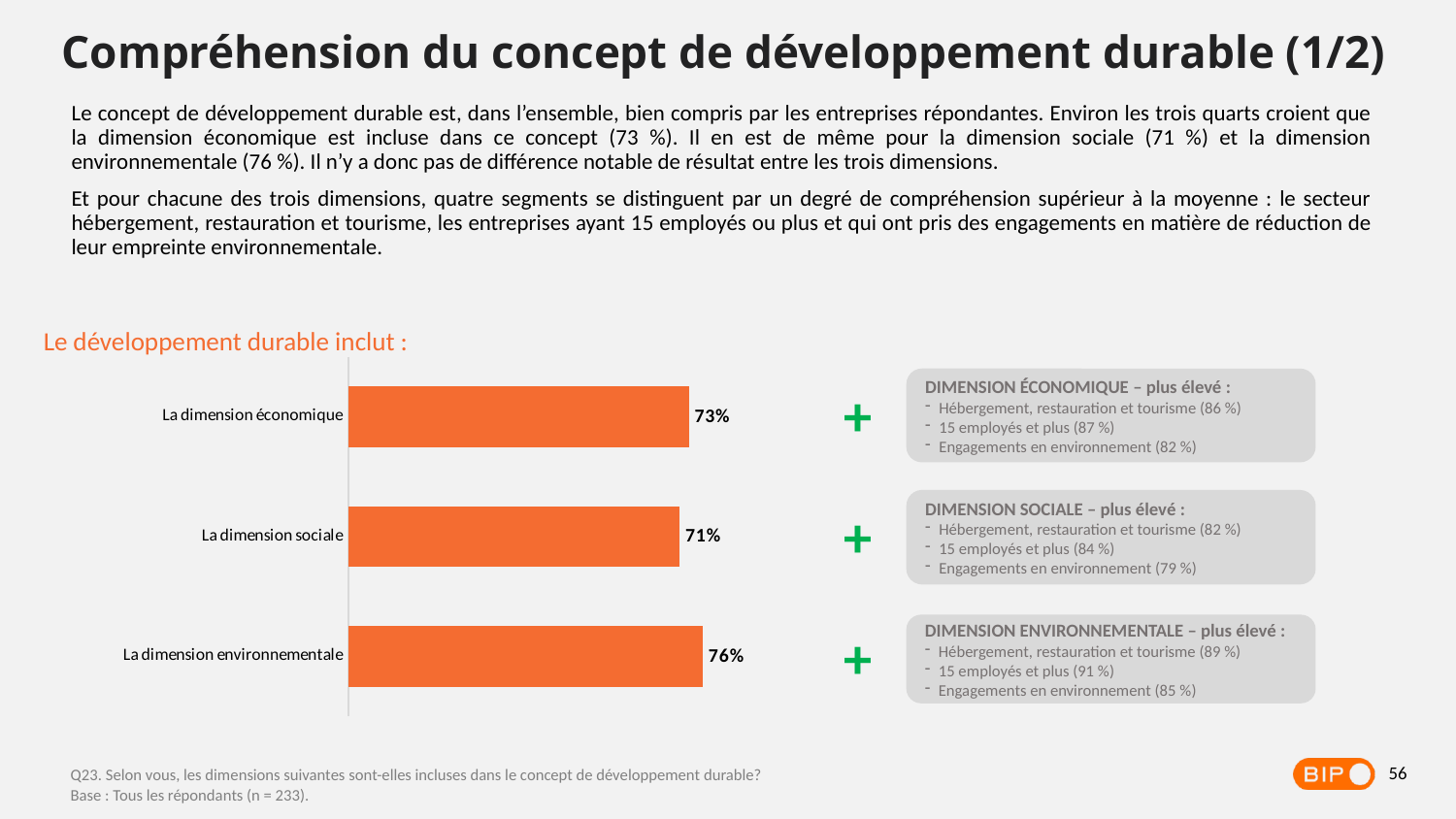
Which is larger: the value for "La dimension économique" or "La dimension environnementale"? La dimension environnementale How many categories are shown in the chart? 3 What is the value for "La dimension environnementale"? 76% What is the value for "La dimension sociale"? 71% Which category has the lowest value? La dimension sociale What colour are the bars in the chart? Orange What is the value for "La dimension économique"? 73% What is the difference between the values for "La dimension environnementale" and "La dimension sociale"? 5% What is the title shown above the chart? Le développement durable inclut : What kind of chart is shown on the slide? Bar chart Which category has the highest value? La dimension environnementale What is the difference between the values for "La dimension économique" and "La dimension sociale"? 2%